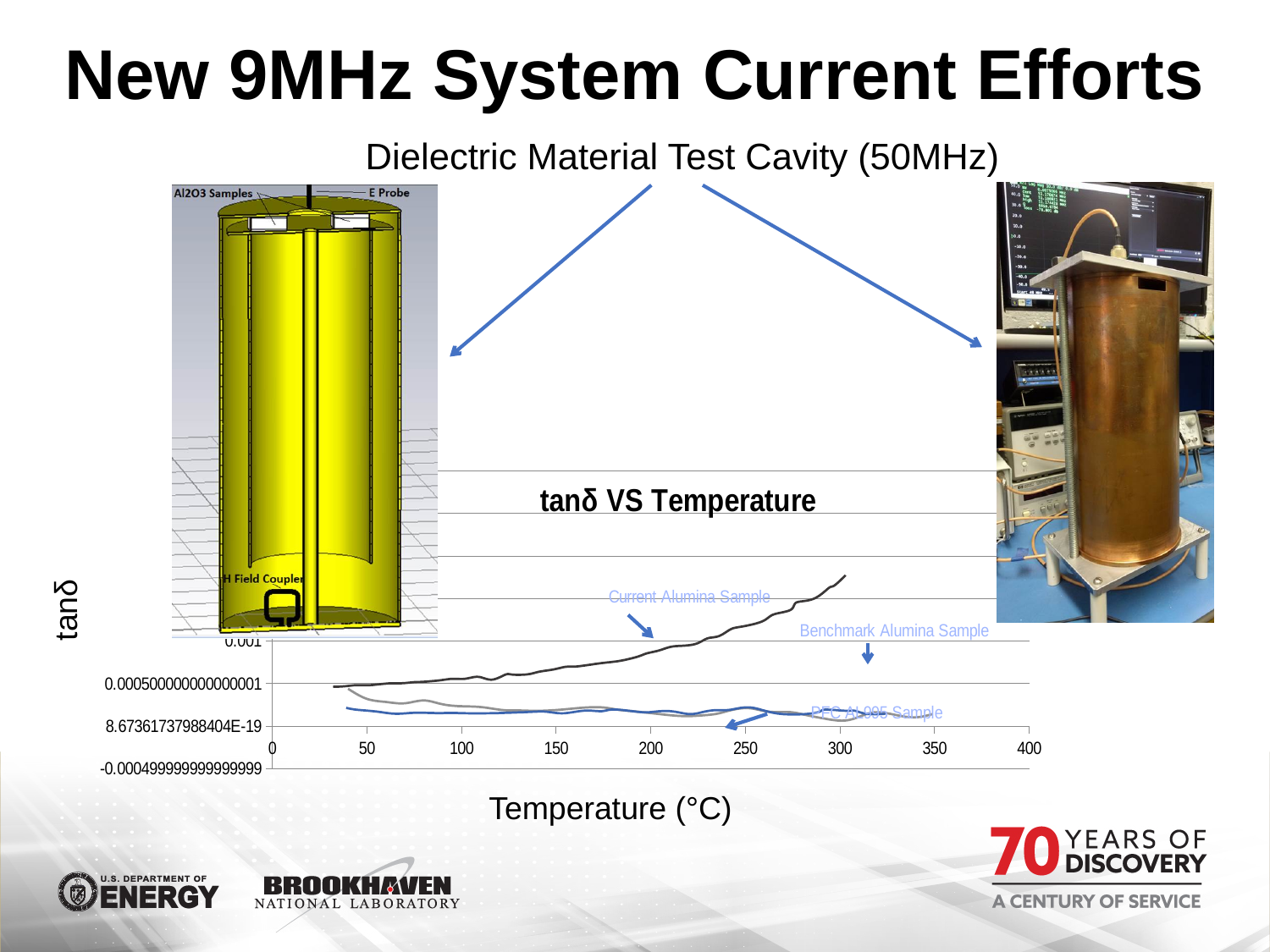
What is the maximum temperature shown on the x axis of the 'tanδ VS Temperature' chart? 400 How many labeled series are shown on the 'tanδ VS Temperature' chart? 3 In the 'tanδ VS Temperature' chart, does the Current Alumina Sample line rise or fall as temperature increases? rises In the 'tanδ VS Temperature' chart, which is larger at 300 °C: the Current Alumina Sample or the Benchmark Alumina Sample? Current Alumina Sample What is the title of the chart on the slide? tanδ VS Temperature What is the x-axis label of the 'tanδ VS Temperature' chart? Temperature (°C) In the 'tanδ VS Temperature' chart, is the value for the Benchmark Alumina Sample at 250 °C greater or less than 0.0005? less In the 'tanδ VS Temperature' chart, which series has the highest tanδ at 300 °C? Current Alumina Sample In the 'tanδ VS Temperature' chart, is the value for the Current Alumina Sample at 300 °C greater or less than 0.001? greater What kind of chart is the 'tanδ VS Temperature' chart? line chart